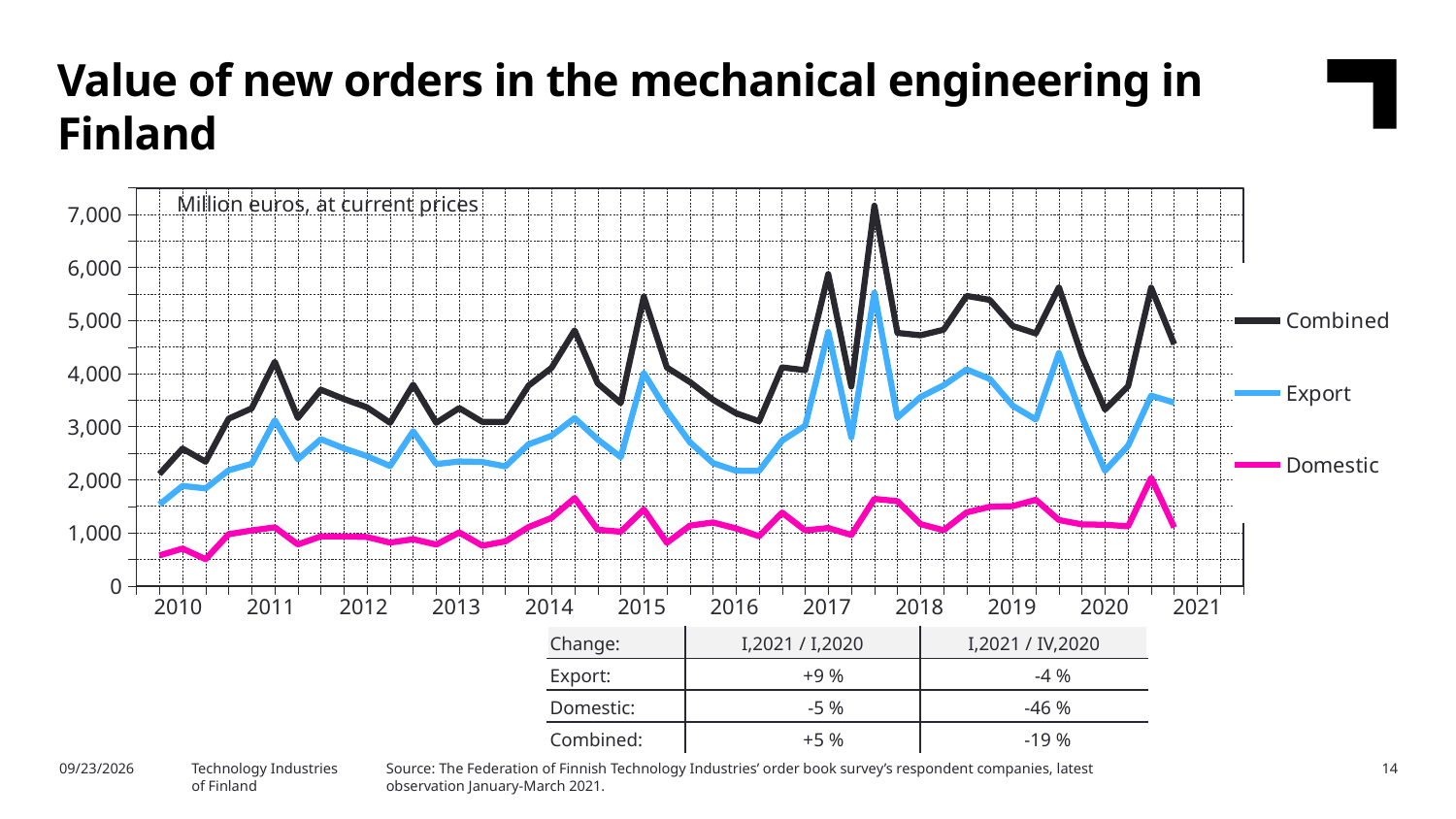
Which series has the highest values throughout the chart? Combined In 2015, which is larger, the Export value or the Domestic value? Export Is the last plotted value for Combined (2021) greater or less than 4,000? greater How many years are labelled on the x axis? 12 Is the last plotted value for Domestic (2021) greater or less than 2,000? less Which series has the lowest values throughout the chart? Domestic Is the peak value of the Combined series in 2017 greater or less than 7,000? greater How many series does the legend list? 3 What kind of chart is shown on the slide? line chart Does the Combined series rise or fall from the start of 2010 to the start of 2011? rise What unit is stated in the chart's subtitle? Million euros, at current prices